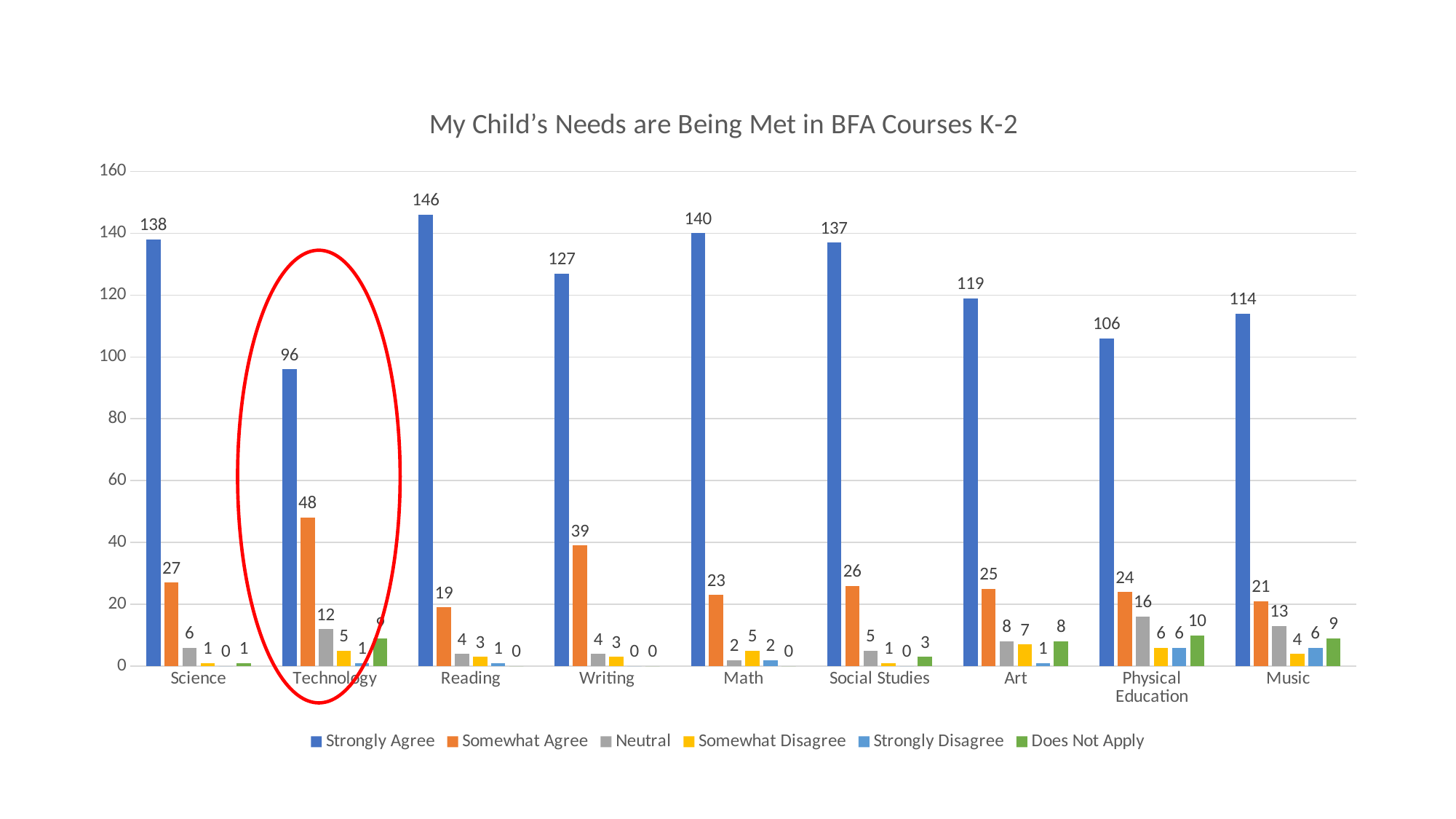
How many series does the legend list? 6 Is the Strongly Agree value for Physical Education greater or less than 100? greater How many courses are shown on the x axis? 9 Which has a larger Strongly Agree value, Art or Music? Art What kind of chart is shown on the slide? bar chart What is the Somewhat Agree value for Technology? 48 Which course has the highest Somewhat Agree value? Technology What is the Strongly Agree value for Reading? 146 Which course has the lowest Strongly Agree value? Technology What is the Neutral value for Physical Education? 16 What is the difference between the Strongly Agree values for Science and Technology? 42 Which course has the highest Strongly Agree value? Reading